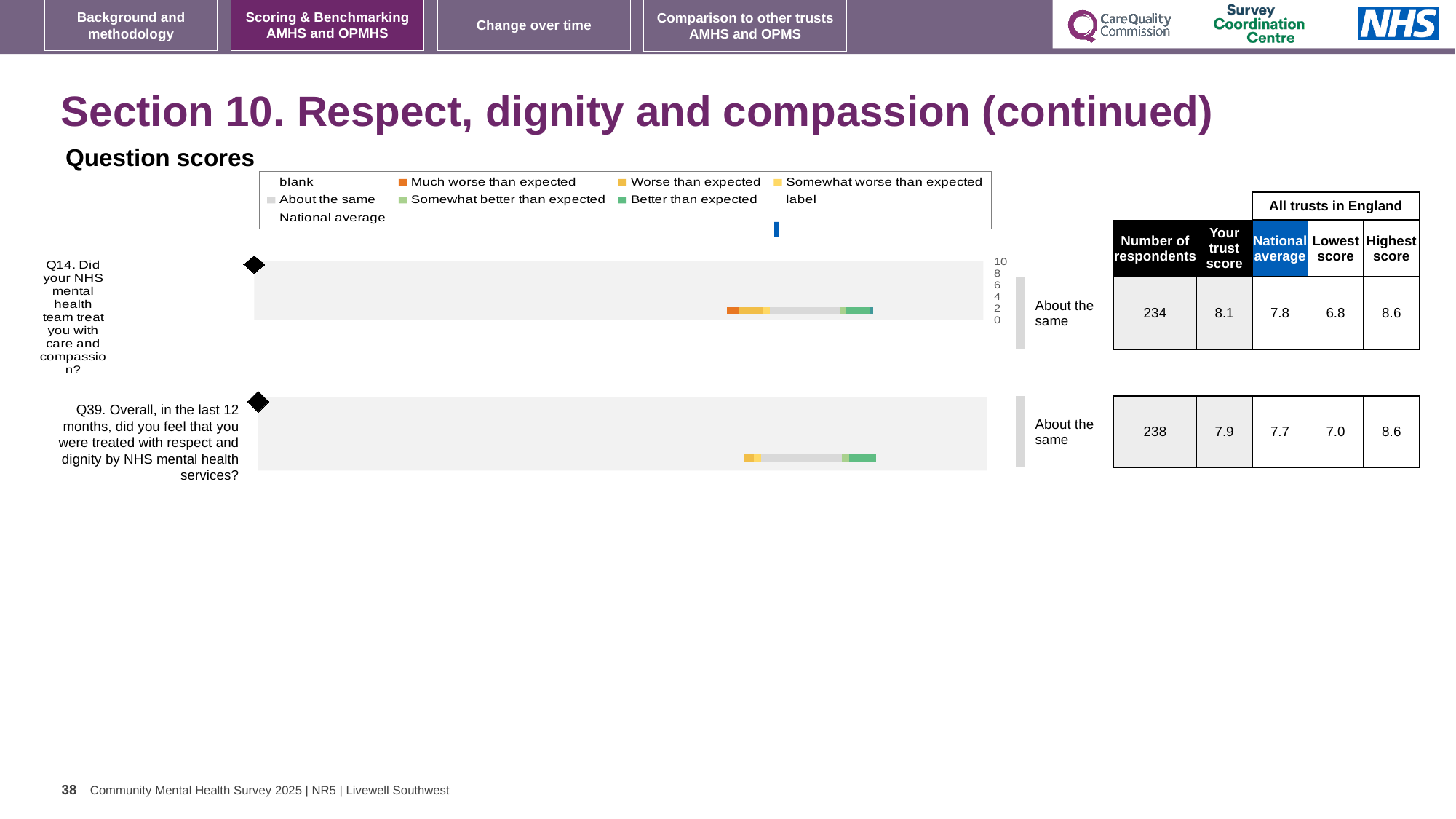
How many questions are plotted in the chart? 2 What is the trust score for Q14 (Did your NHS mental health team treat you with care and compassion?)? 8.1 What is the national average score for Q39 (treated with respect and dignity by NHS mental health services)? 7.7 Which question has the higher trust score, Q14 or Q39? Q14 What is the lowest score among all trusts in England for Q14? 6.8 How many respondents answered Q39? 238 Which legend entry is shown in orange? Much worse than expected What is the difference between the trust score and the national average for Q14? 0.3 What is the highest score among all trusts in England for Q39? 8.6 What is the difference between the highest and lowest scores for Q39? 1.6 What benchmark category is shown for Q14? About the same What kind of chart is used to show the question scores? Bar chart